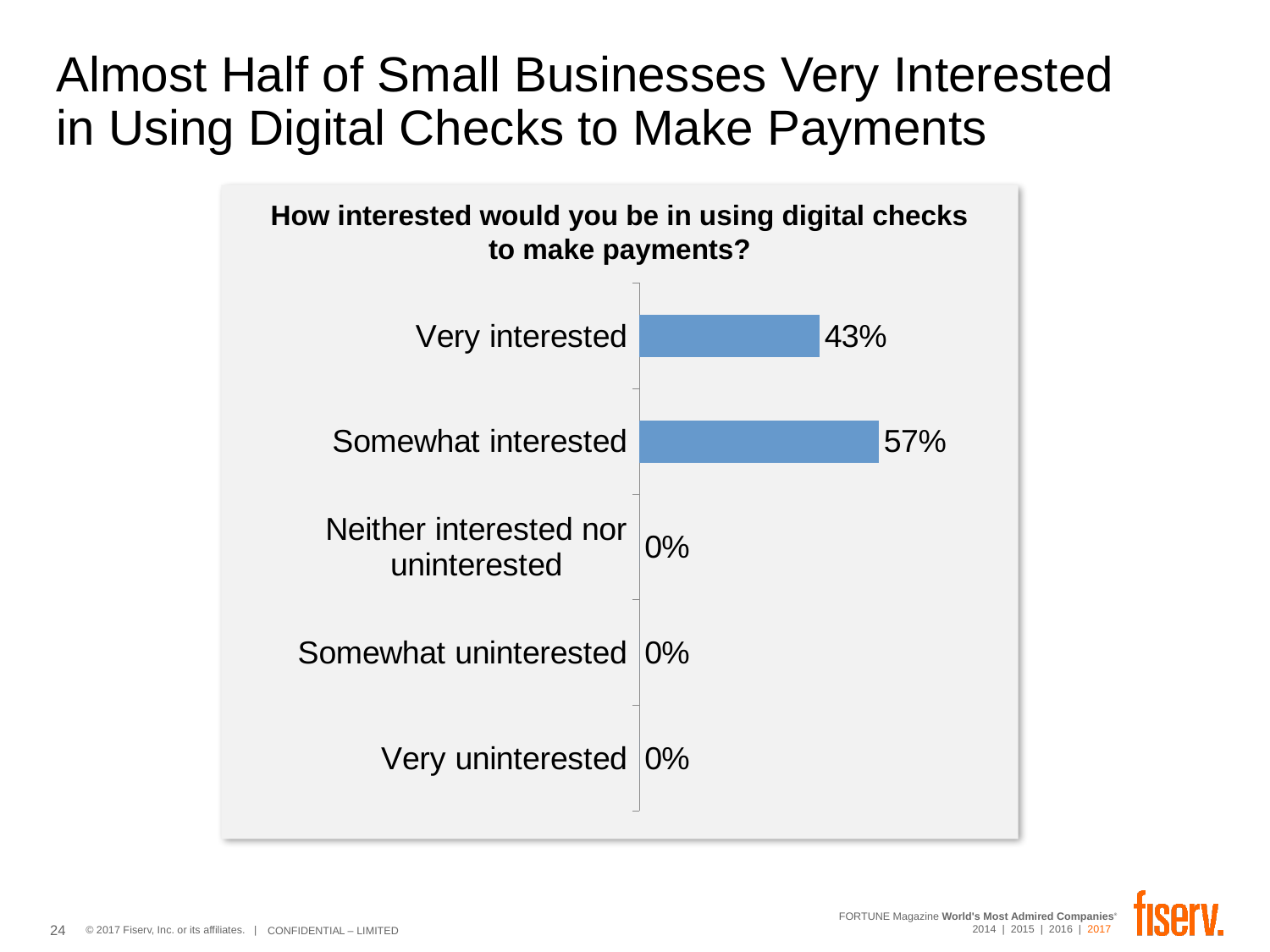
Which response category has the highest value? Somewhat interested What type of chart is shown on the slide? Bar chart What is the combined value of 'Very interested' and 'Somewhat interested'? 100% What question is shown as the chart's title? How interested would you be in using digital checks to make payments? How many response categories are shown in the chart? 5 How many categories have a value of 0%? 3 Which is larger, the value for 'Very interested' or the value for 'Somewhat interested'? Somewhat interested What is the difference between the 'Somewhat interested' and 'Very interested' values? 14% What percentage of respondents said they were somewhat interested? 57% What percentage of respondents said they were very interested in using digital checks to make payments? 43% What is the value shown for 'Neither interested nor uninterested'? 0% What is the value shown for 'Very uninterested'? 0%